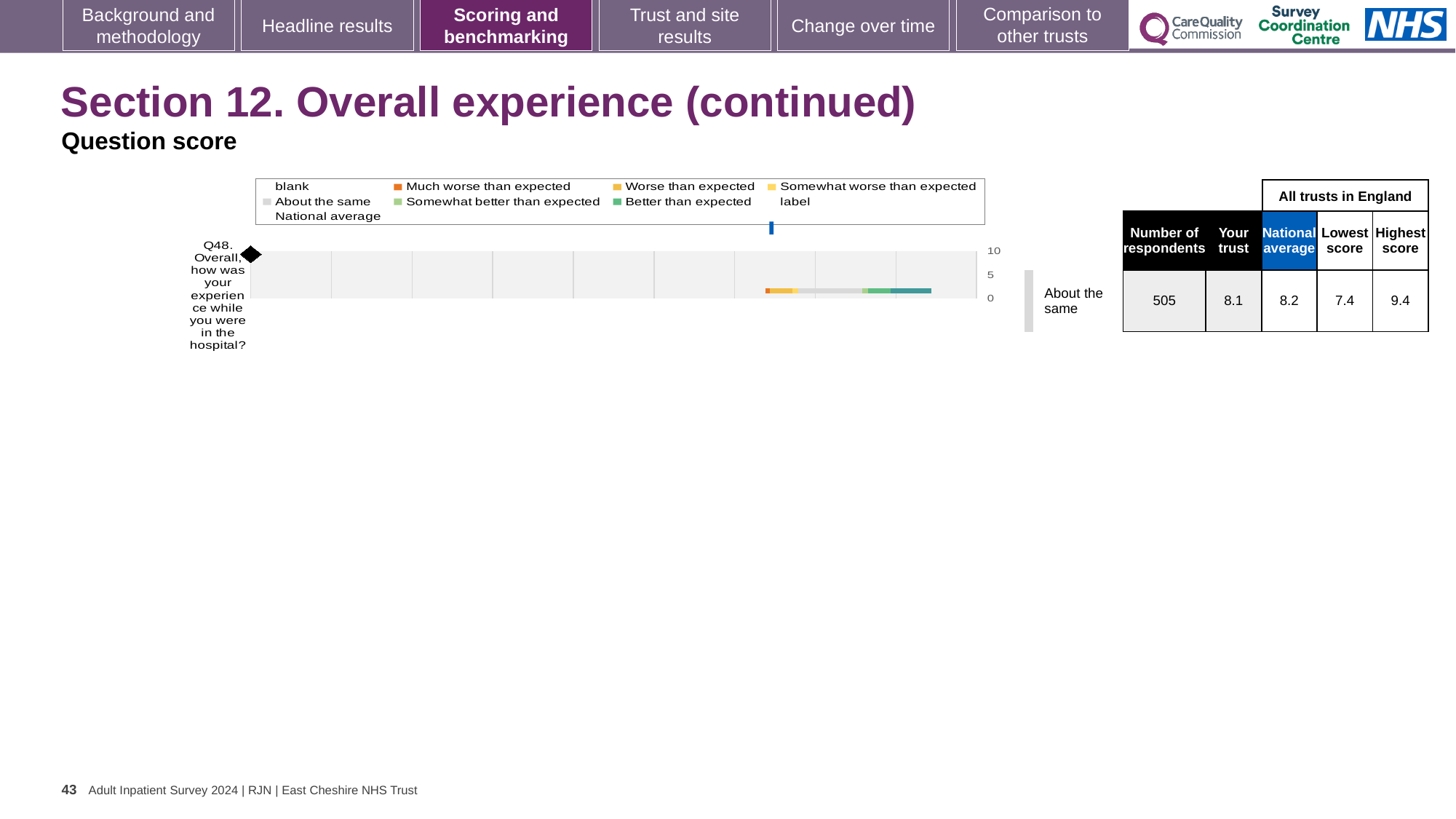
What is the highest score among all trusts in England for Q48? 9.4 What is the national average score for Q48? 8.2 What is the lowest score among all trusts in England for Q48? 7.4 What benchmark category is the trust's Q48 score placed in? About the same Which is larger for Q48, the 'Your trust' score or the national average? National average What kind of chart is shown on the slide? bar chart How many respondents answered Q48? 505 How many questions (categories) are plotted on the chart? 1 Which question is plotted on the chart? Q48. Overall, how was your experience while you were in the hospital? What is the difference between the highest and lowest scores for Q48 across all trusts in England? 2.0 What is the 'Your trust' score for Q48? 8.1 Which legend entry is shown in orange? Much worse than expected